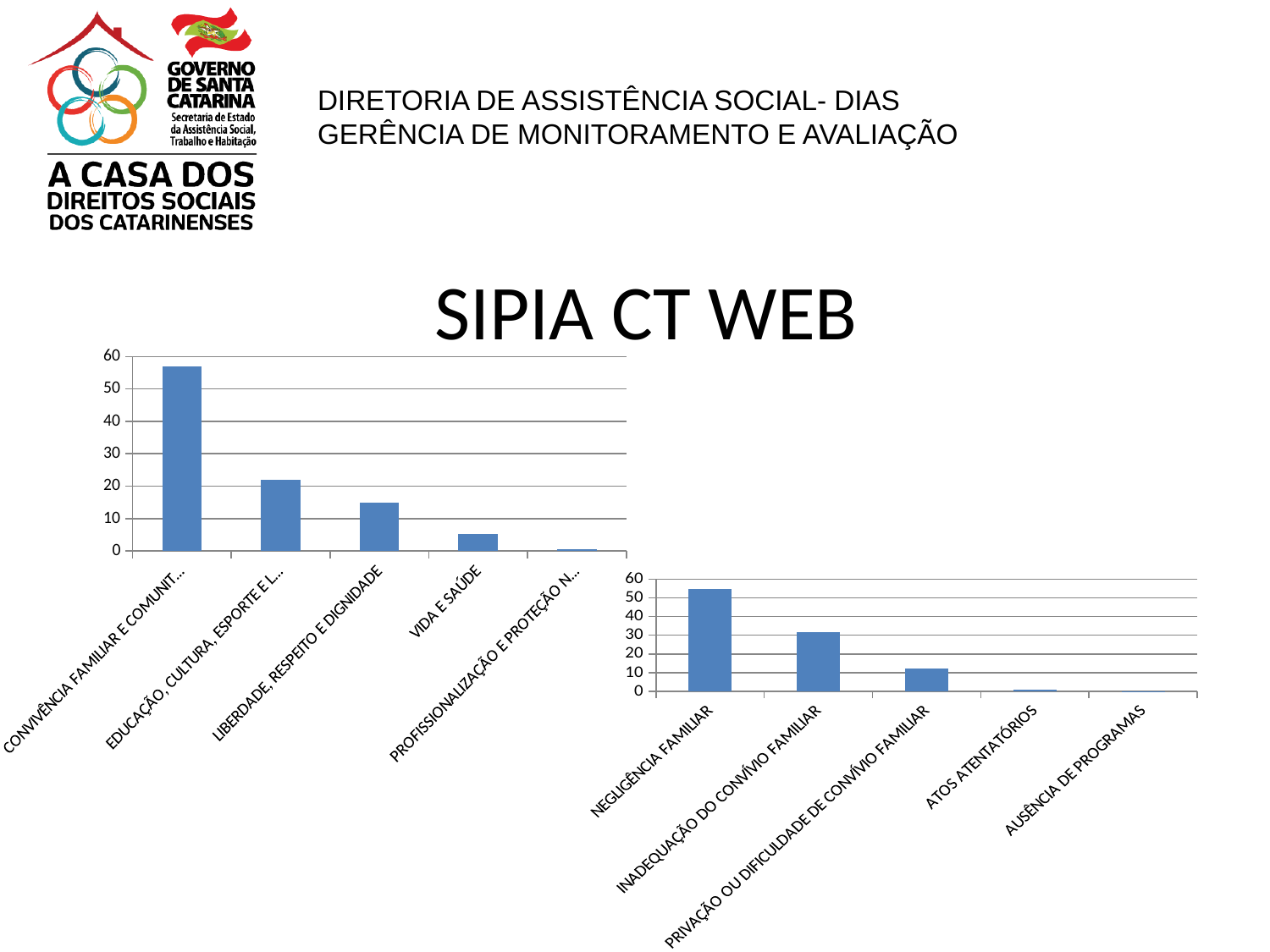
In the right chart, which category has the lowest value? AUSÊNCIA DE PROGRAMAS In the right chart, is the value for INADEQUAÇÃO DO CONVÍVIO FAMILIAR greater or less than 20? greater What kind of chart is the left chart on the slide? bar chart In the right chart, which is larger: PRIVAÇÃO OU DIFICULDADE DE CONVÍVIO FAMILIAR or ATOS ATENTATÓRIOS? PRIVAÇÃO OU DIFICULDADE DE CONVÍVIO FAMILIAR In the left chart, which category has the highest value? CONVIVÊNCIA FAMILIAR E COMUNIT... In the left chart, which category has the lowest value? PROFISSIONALIZAÇÃO E PROTEÇÃO N... In the left chart, is the value for LIBERDADE, RESPEITO E DIGNIDADE greater or less than 20? less In the right chart, do the values rise or fall from left to right along the x axis? fall How many categories does the left chart show? 5 How many categories does the right chart show? 5 In the left chart, is the value for CONVIVÊNCIA FAMILIAR E COMUNIT... greater or less than 50? greater In the right chart, which category has the highest value? NEGLIGÊNCIA FAMILIAR